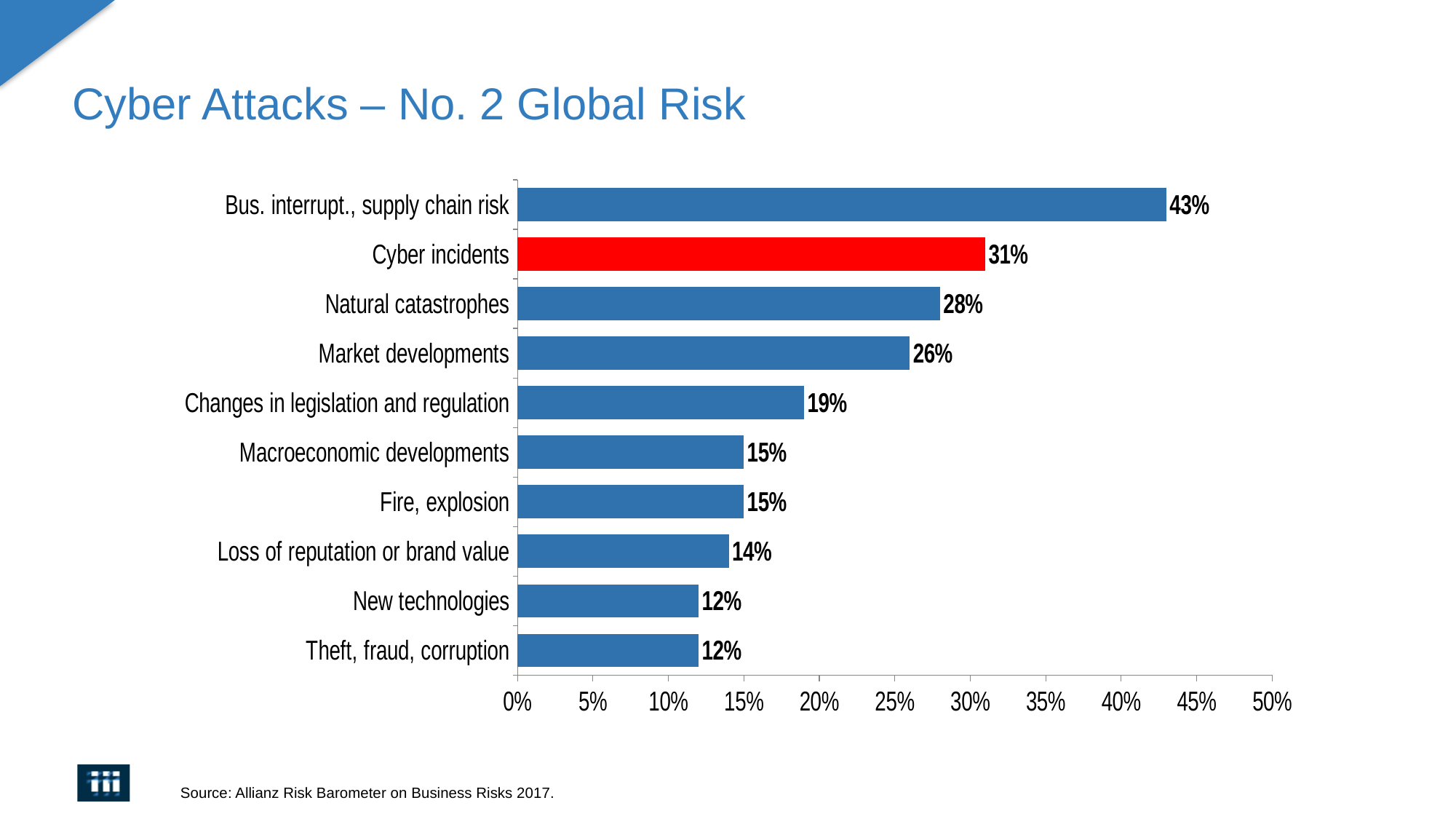
What is the value for Changes in legislation and regulation? 19% What is the value for Natural catastrophes? 28% What is the title of the slide? Cyber Attacks – No. 2 Global Risk What is the difference between the values for Market developments and Loss of reputation or brand value? 12% What is the difference between the values for Bus. interrupt., supply chain risk and Cyber incidents? 12% Which bar is coloured red? Cyber incidents What is the value for Cyber incidents? 31% Which is larger, the value for Natural catastrophes or the value for Market developments? Natural catastrophes What kind of chart is shown on the slide? bar chart Which category has the highest value? Bus. interrupt., supply chain risk Is the value for Cyber incidents greater or less than 30%? greater How many categories are shown in the chart? 10